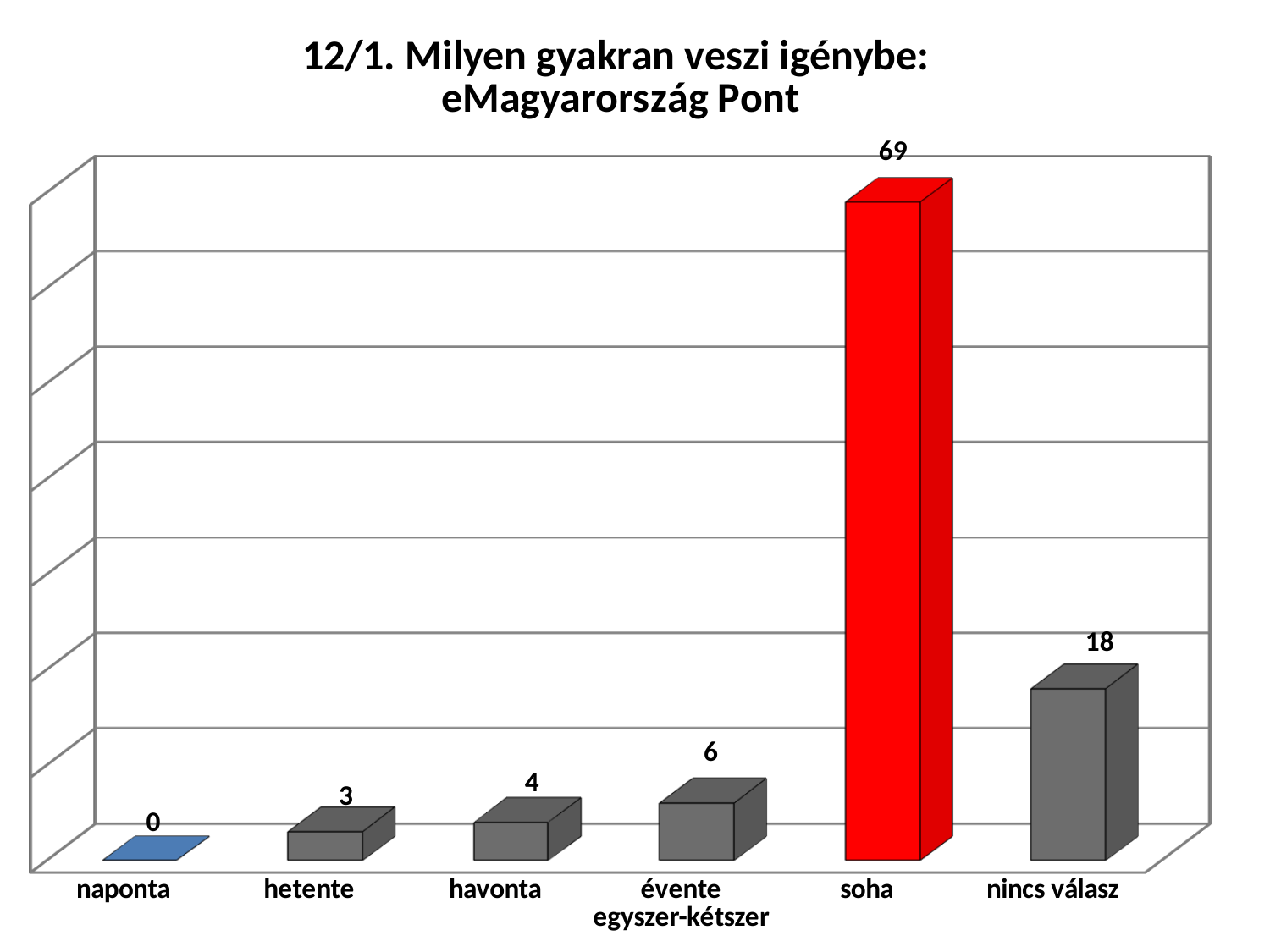
How many categories are shown on the x axis? 6 Which category has the highest value? soha What is the value for "nincs válasz"? 18 Which is larger, the value for "évente egyszer-kétszer" or the value for "havonta"? évente egyszer-kétszer What is the title of the chart? 12/1. Milyen gyakran veszi igénybe: eMagyarország Pont What is the difference between the values for "havonta" and "hetente"? 1 What is the value for "naponta"? 0 What is the difference between the values for "soha" and "nincs válasz"? 51 What kind of chart is shown on the slide? bar chart What is the value for "évente egyszer-kétszer"? 6 Which category has the lowest value? naponta What is the value for "soha"? 69